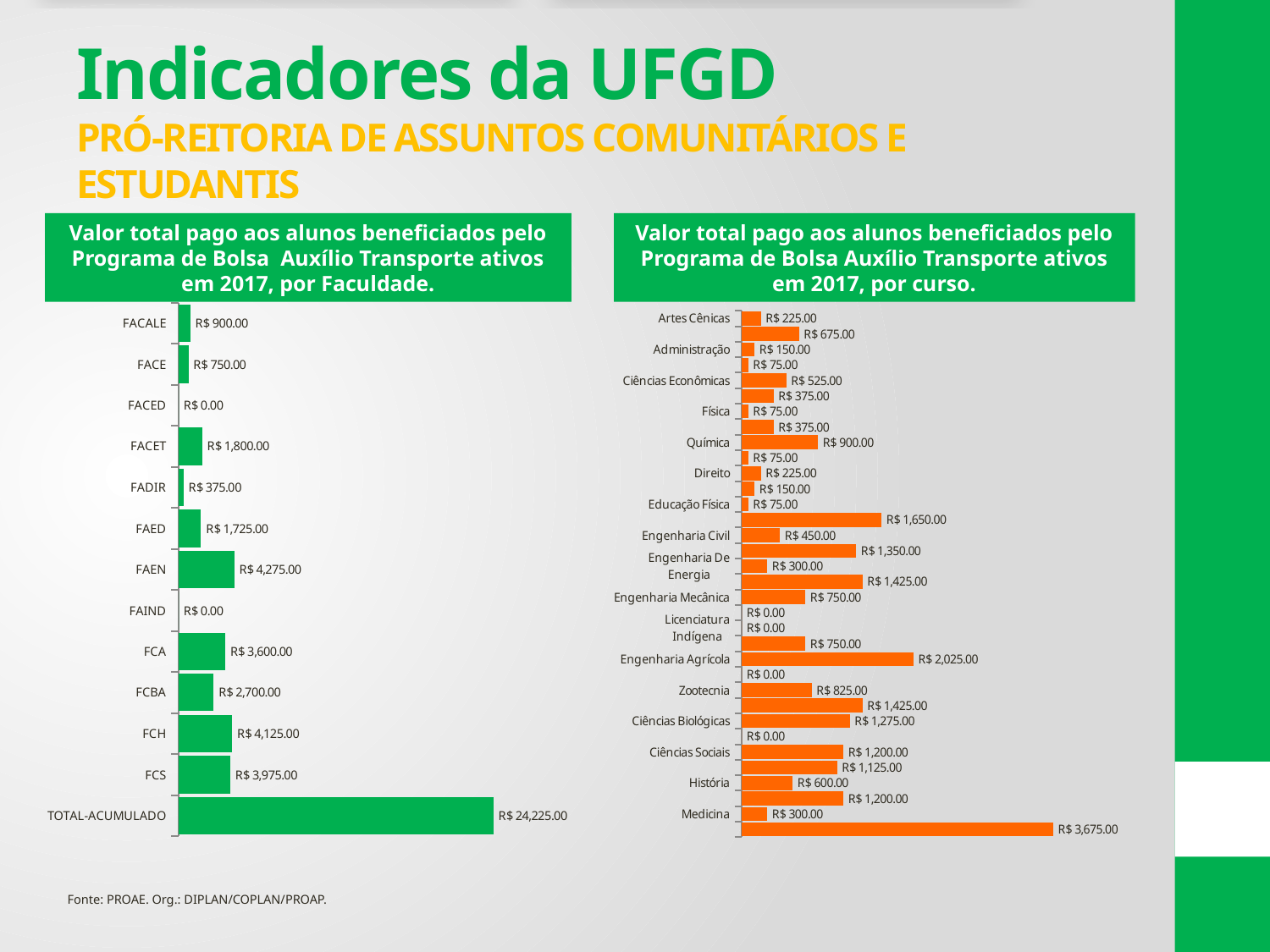
In the right chart (por curso), what is the value for Engenharia Agrícola? R$ 2,025.00 What kind of chart is the left chart (por Faculdade)? Bar chart In the left chart (por Faculdade), how many categories are plotted, including TOTAL-ACUMULADO? 13 In the left chart (por Faculdade), what is the value for FAEN? R$ 4,275.00 What colour are the bars in the right chart (por curso)? Orange In the left chart (por Faculdade), how many faculties show a value of R$ 0.00? 2 In the left chart (por Faculdade), what is the value for FACET? R$ 1,800.00 In the left chart (por Faculdade), excluding TOTAL-ACUMULADO, which faculty has the highest value? FAEN In the left chart (por Faculdade), what is the value shown for TOTAL-ACUMULADO? R$ 24,225.00 In the left chart (por Faculdade), what is the difference between the values for FAEN and FAED? R$ 2,550.00 In the left chart (por Faculdade), what is the difference between the values for FCH and FCS? R$ 150.00 In the left chart (por Faculdade), which is larger, the value for FCA or the value for FCBA? FCA